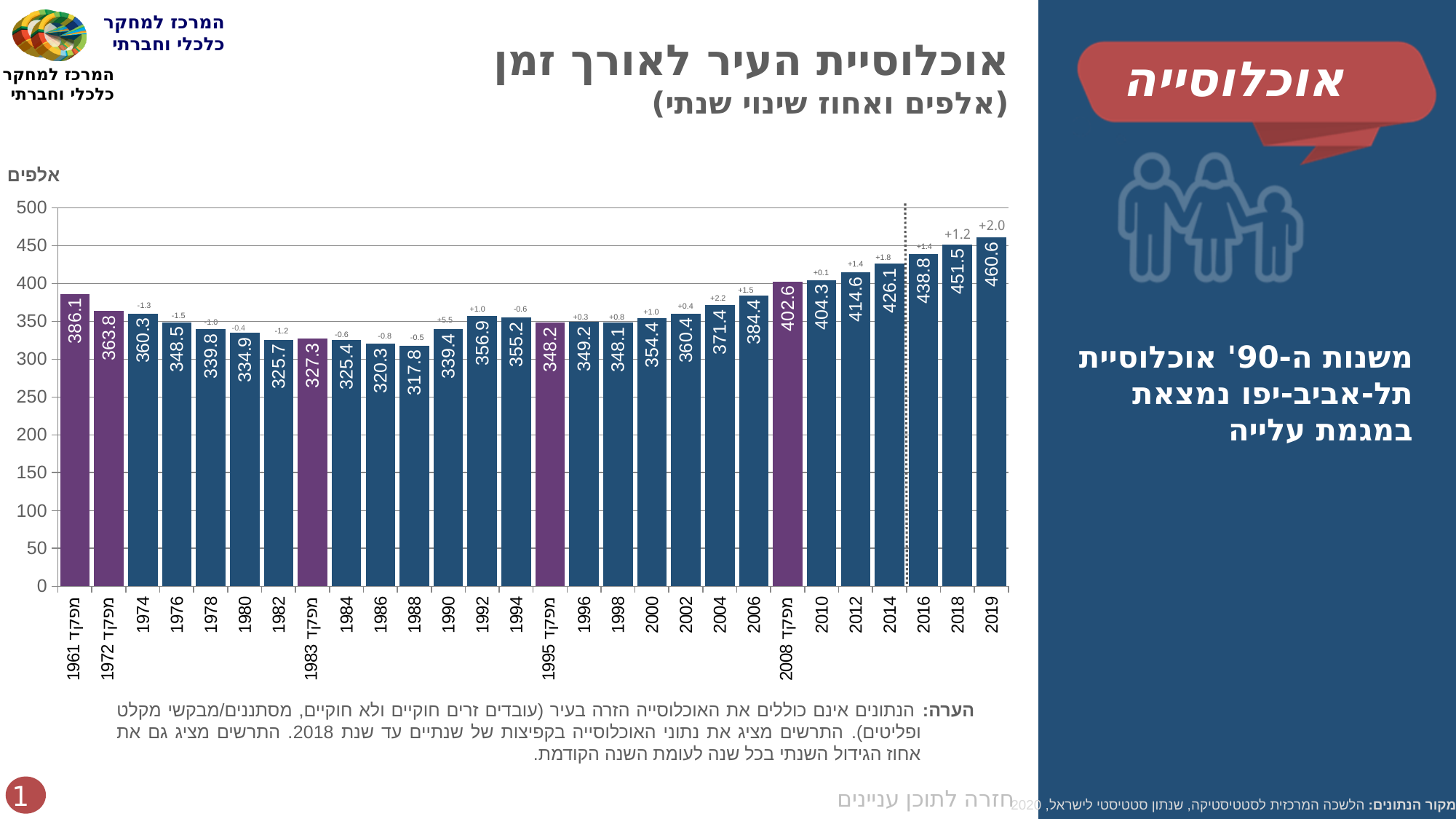
Which year has the lowest population value on the chart? 1988 What is the population value shown for 1988? 317.8 What annual percentage change is labelled above the 2019 bar? +2.0 Is the population value for 2014 greater or less than 400? greater What is the population value shown for 2008 census (מפקד 2008)? 402.6 Which year has the highest population value on the chart? 2019 Which is larger, the population value for 1992 or for 1994? 1992 What is the difference between the population values for 2019 and 2018? 9.1 What is the population value shown for the 1961 census (מפקד 1961)? 386.1 How many bars are plotted on the chart? 28 What is the population value shown for 2019? 460.6 What kind of chart is shown on the slide? bar chart